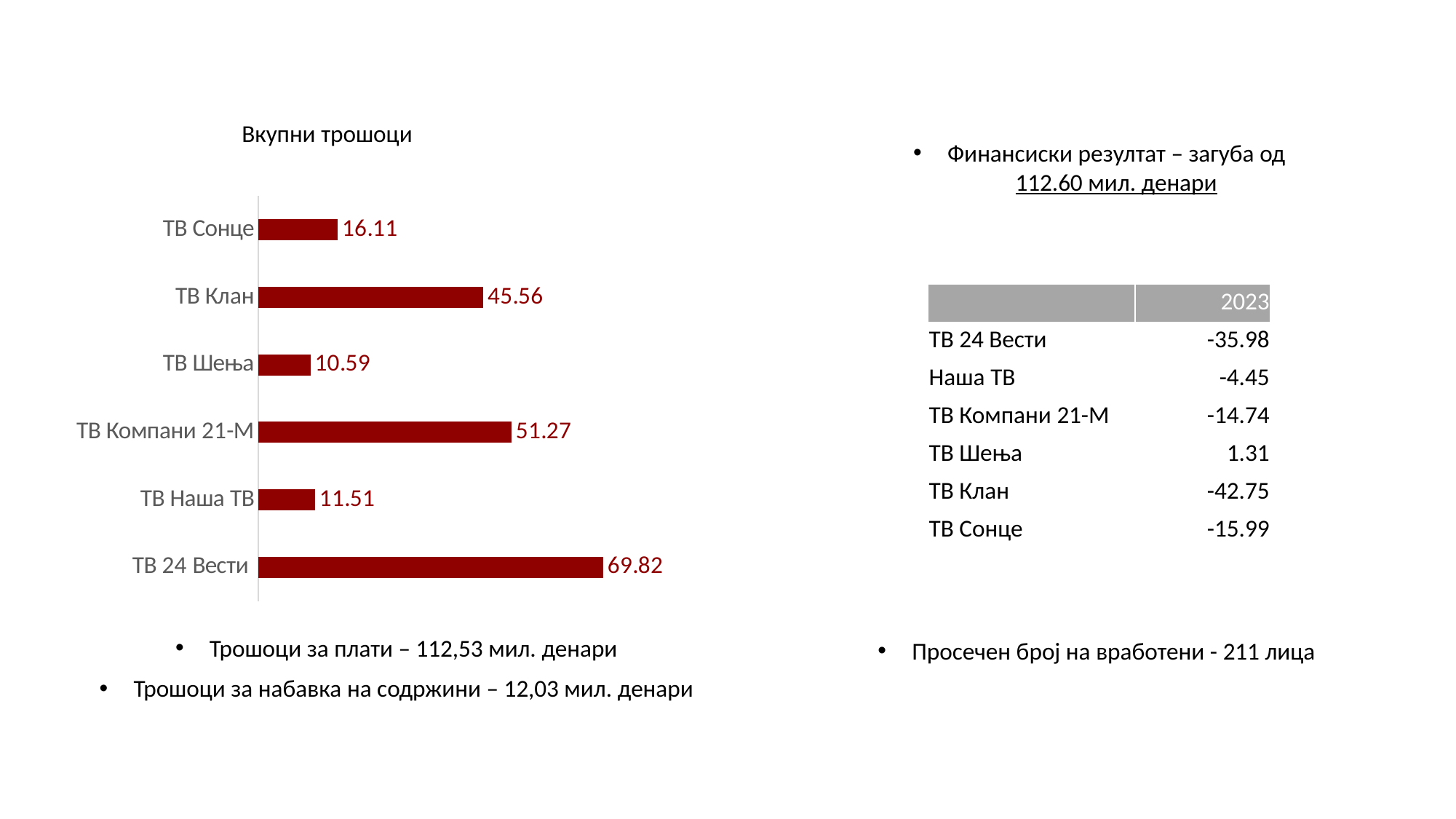
What is the value for ТВ Клан in the Вкупни трошоци chart? 45.56 What is the value for ТВ Сонце in the Вкупни трошоци chart? 16.11 What kind of chart is the Вкупни трошоци chart? bar chart What is the difference between the values for ТВ 24 Вести and ТВ Компани 21-М in the Вкупни трошоци chart? 18.55 Which is larger in the Вкупни трошоци chart, the value for ТВ Клан or the value for ТВ Компани 21-М? ТВ Компани 21-М Which category has the highest value in the Вкупни трошоци chart? ТВ 24 Вести What is the difference between the values for ТВ Сонце and ТВ Наша ТВ in the Вкупни трошоци chart? 4.60 What is the value for ТВ Шења in the Вкупни трошоци chart? 10.59 What is the value for ТВ 24 Вести in the Вкупни трошоци chart? 69.82 How many categories are shown in the Вкупни трошоци chart? 6 Which category has the lowest value in the Вкупни трошоци chart? ТВ Шења What is the title of the chart on the slide? Вкупни трошоци